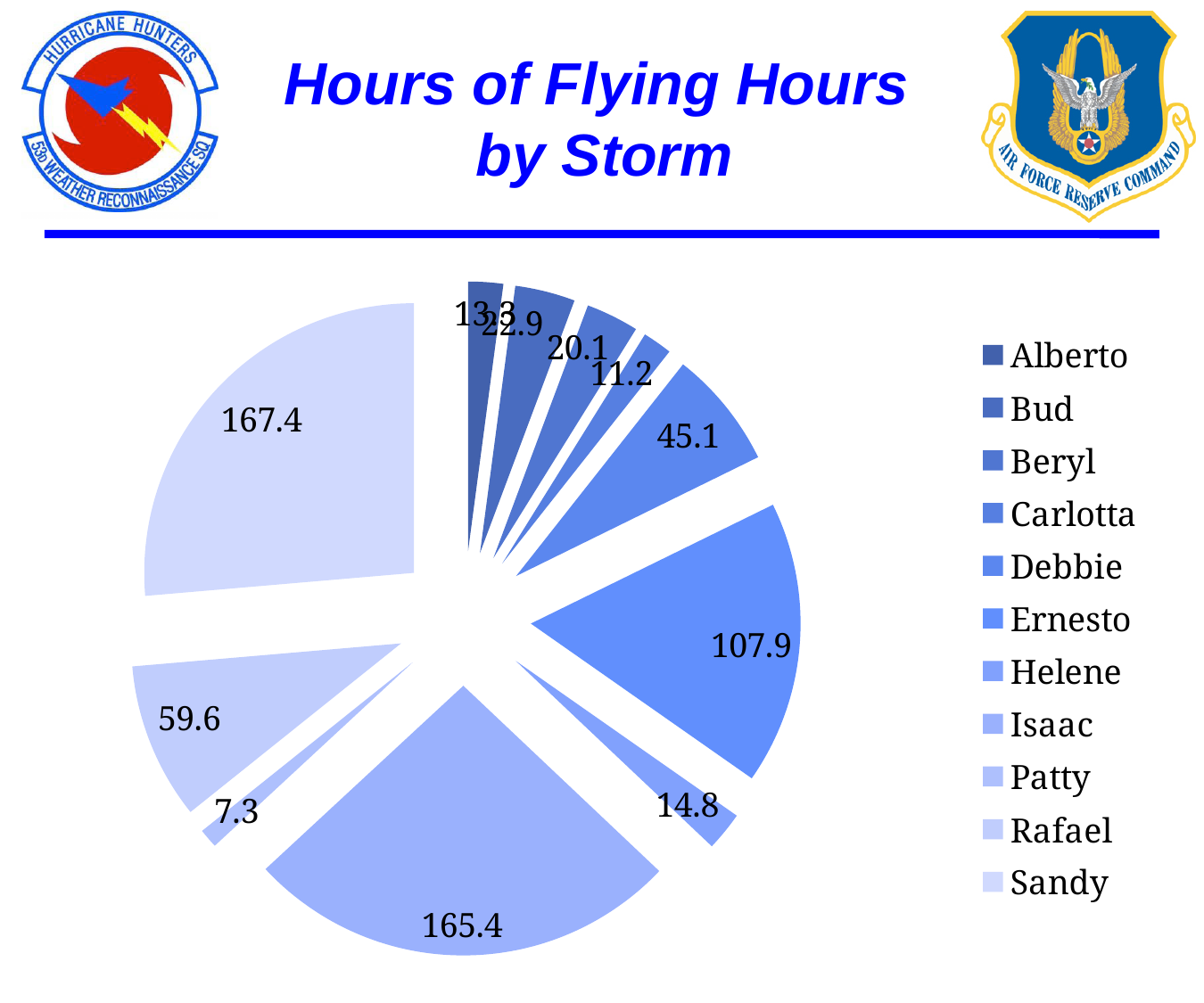
Which has a larger value, Rafael or Helene? Rafael What is the difference between the values for Ernesto and Debbie? 62.8 Which storm has the smallest slice of the pie? Patty What is the title of the chart? Hours of Flying Hours by Storm How many storms does the legend list? 11 What is the value shown for Patty? 7.3 What is the value shown for Debbie? 45.1 Which storm has the largest slice of the pie? Sandy What is the value shown for Isaac? 165.4 What is the value shown for Sandy? 167.4 What type of chart is shown on the slide? Pie chart What is the value shown for Ernesto? 107.9